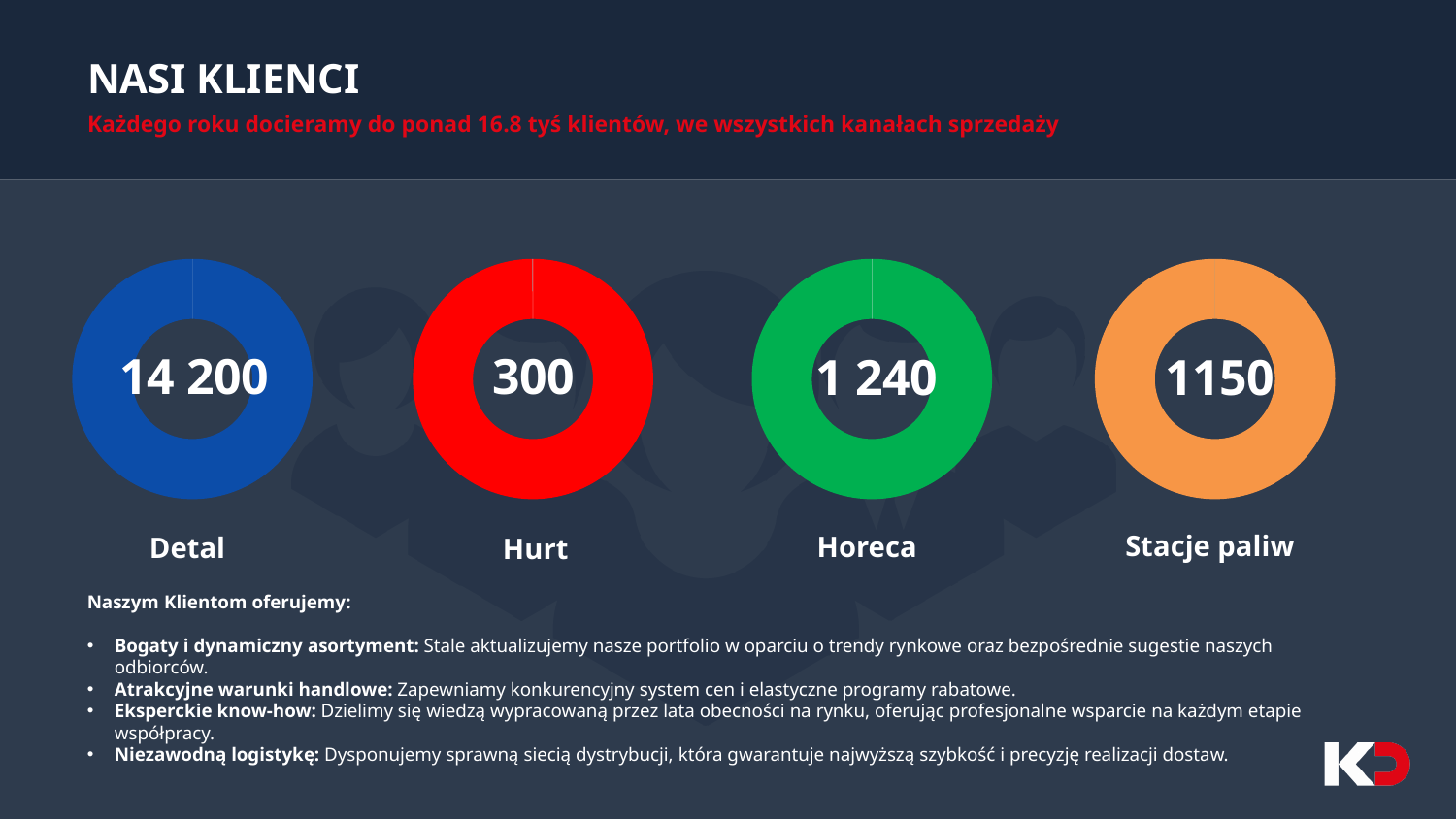
What value is shown in the centre of the Stacje paliw donut chart? 1150 What is the difference between the Horeca value and the Stacje paliw value? 90 What value is shown in the centre of the Detal donut chart? 14 200 What colour is the Horeca donut chart? Green How many donut charts are shown on the slide? 4 What value is shown in the centre of the Horeca donut chart? 1 240 Which has the larger value, Horeca or Stacje paliw? Horeca What is the difference between the Detal value and the Hurt value? 13 900 Which of the four customer segments shown in the donut charts has the lowest value? Hurt What value is shown in the centre of the Hurt donut chart? 300 What kind of chart is used to display the customer segment values? Donut chart Which of the four customer segments shown in the donut charts has the highest value? Detal